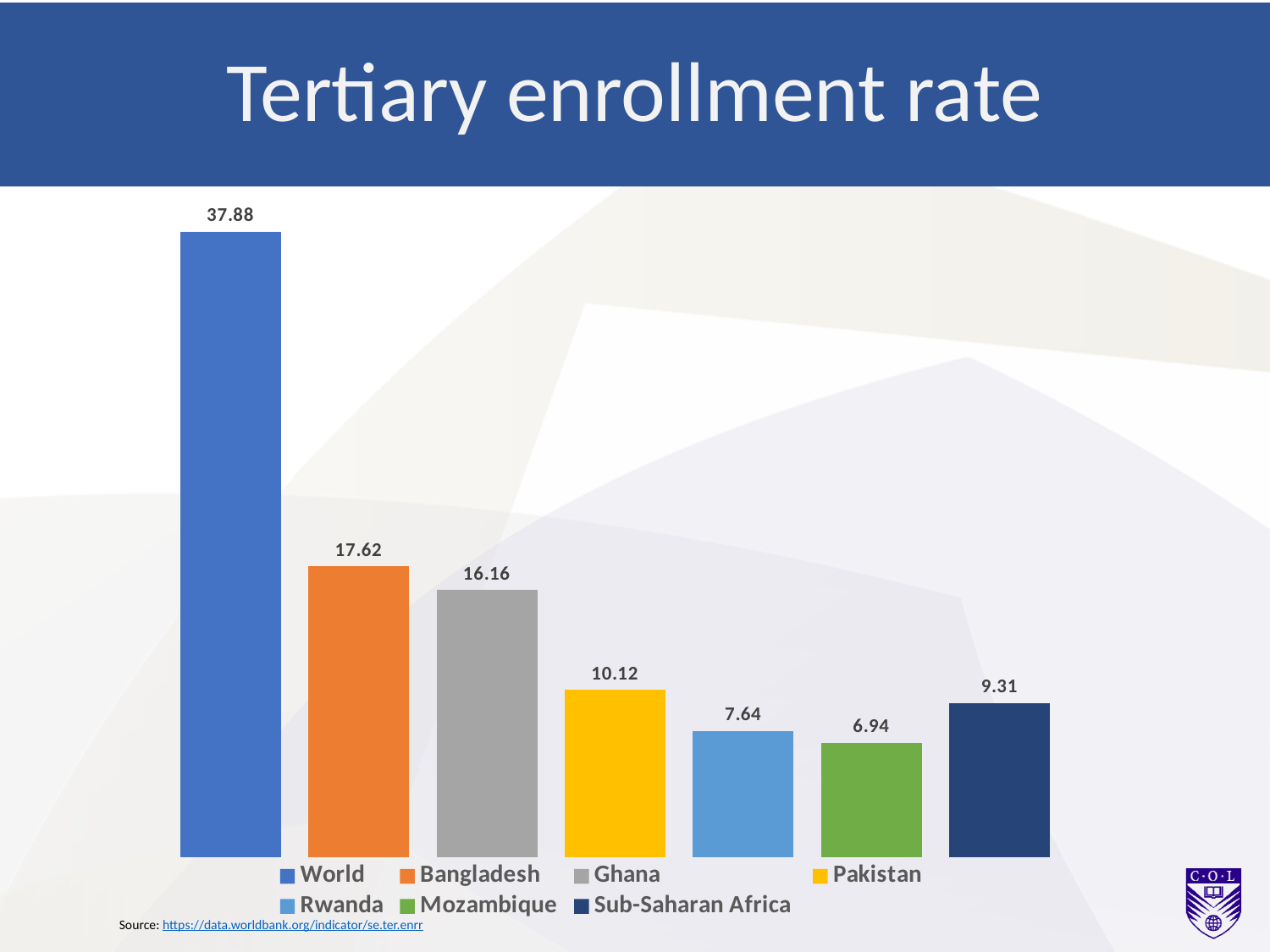
What is the difference between the tertiary enrollment rates of Pakistan and Rwanda? 2.48 How many bars are plotted in the chart? 7 What is the tertiary enrollment rate shown for the World? 37.88 What kind of chart is shown on the slide? Bar chart What is the tertiary enrollment rate shown for Mozambique? 6.94 Which category has the lowest tertiary enrollment rate? Mozambique What is the tertiary enrollment rate shown for Bangladesh? 17.62 How many entries does the legend list? 7 Which has a higher tertiary enrollment rate, Rwanda or Sub-Saharan Africa? Sub-Saharan Africa What is the tertiary enrollment rate shown for Sub-Saharan Africa? 9.31 What is the difference between the tertiary enrollment rates of Bangladesh and Ghana? 1.46 Which category has the highest tertiary enrollment rate? World